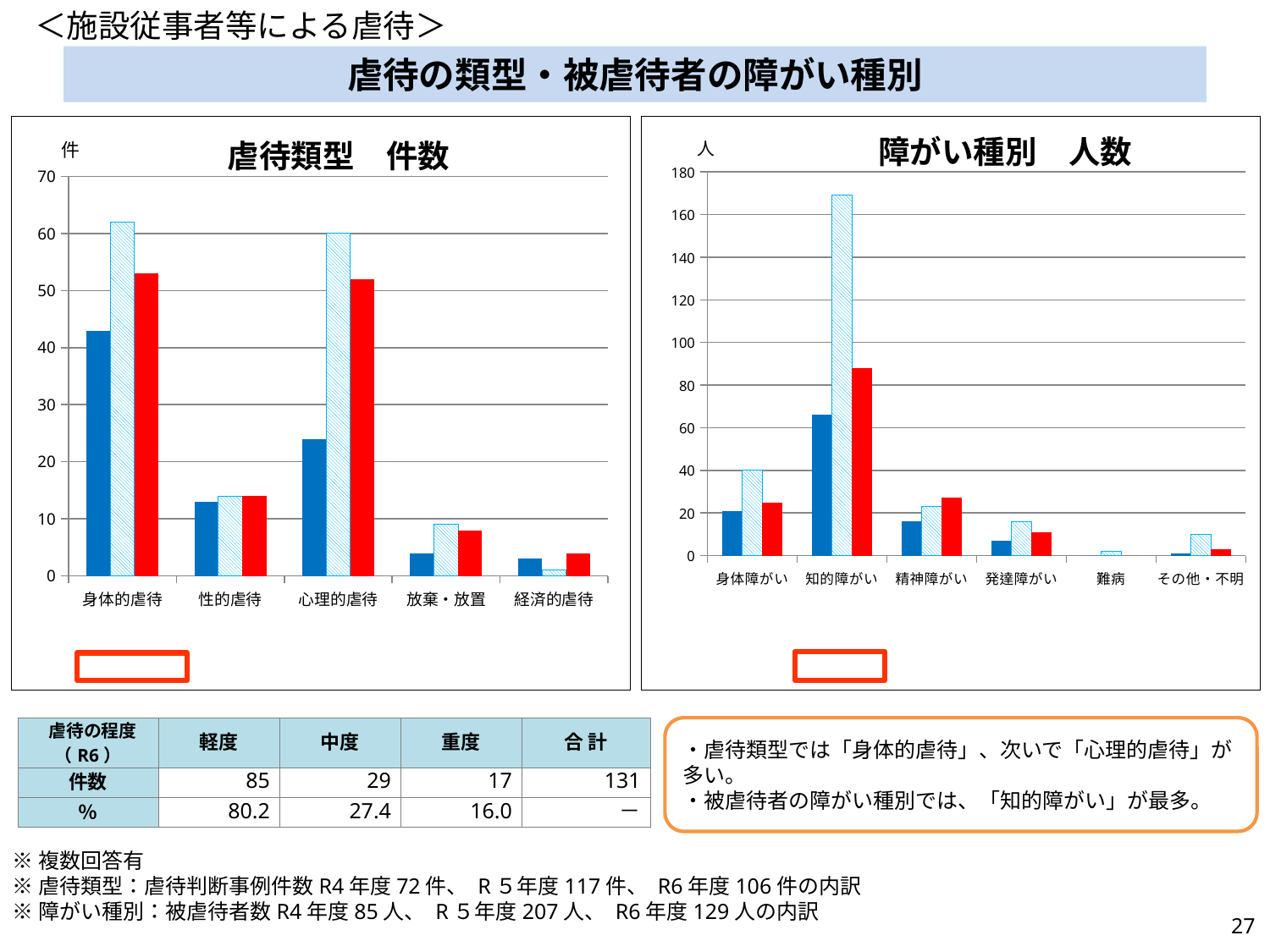
How many categories are shown on the x axis of the left chart (虐待類型 件数)? 5 In the right chart (障がい種別 人数), which category has the lowest bars? 難病 What unit label is shown at the top of the y axis of the right chart (障がい種別 人数)? 人 In the right chart (障がい種別 人数), is the red bar for 知的障がい greater or less than 80? greater In the left chart (虐待類型 件数), which category has the tallest bars? 身体的虐待 In the left chart (虐待類型 件数), which category has the lowest bars overall? 経済的虐待 In the left chart (虐待類型 件数), is the red bar for 身体的虐待 greater or less than 50? greater In the right chart (障がい種別 人数), which category has the tallest bar? 知的障がい In the left chart (虐待類型 件数), which is larger: the blue bar for 身体的虐待 or the blue bar for 心理的虐待? 身体的虐待 In the right chart (障がい種別 人数), is the hatched bar for 知的障がい greater or less than 160? greater What kind of chart is the left chart titled 虐待類型 件数? bar chart How many categories are shown on the x axis of the right chart (障がい種別 人数)? 6